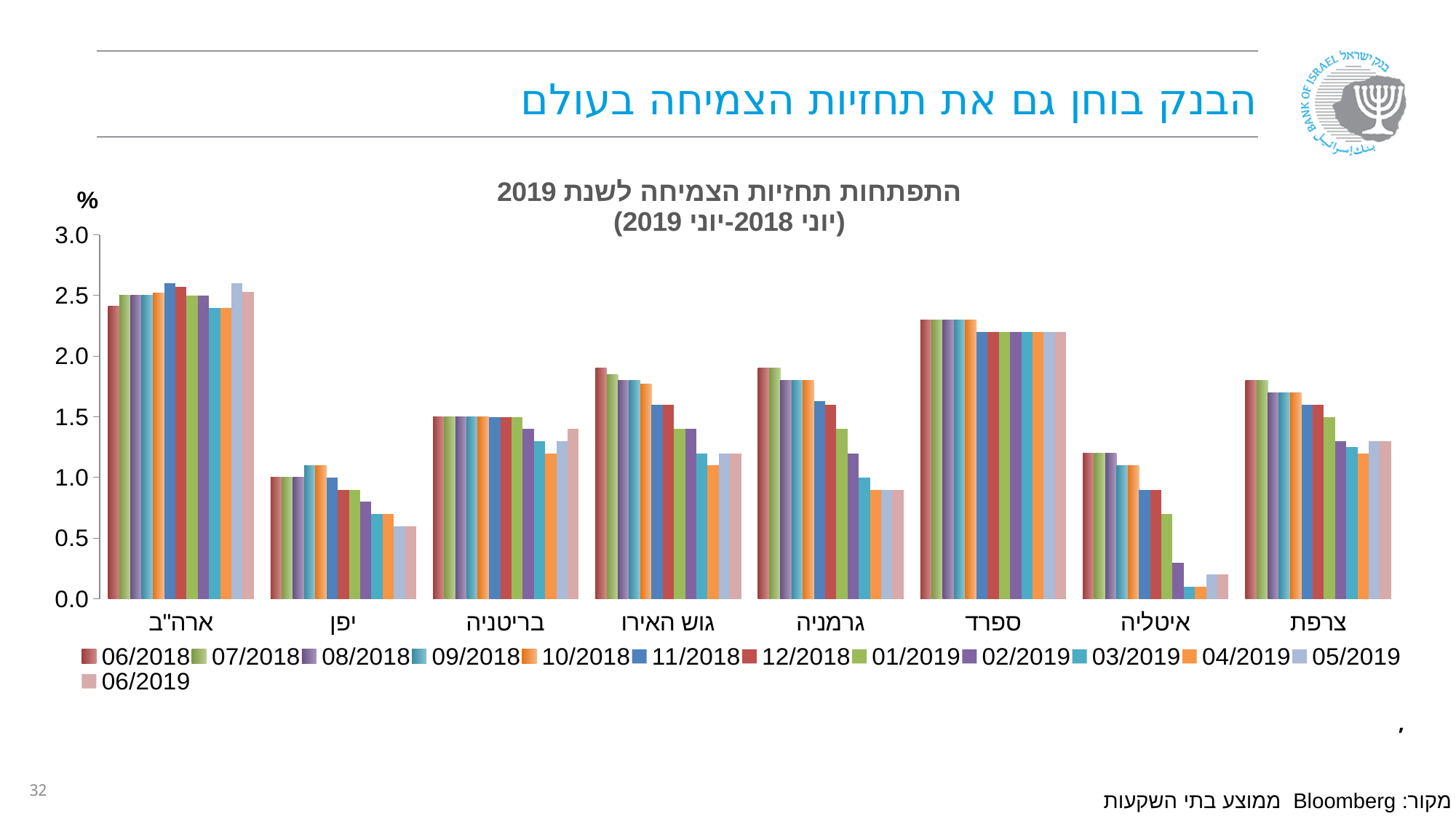
What kind of chart is shown on the slide? bar chart How many series does the legend list? 13 Is the 06/2018 value for ספרד greater or less than 2.0? greater How many countries (categories) are shown on the x axis? 8 Is the 06/2019 value for איטליה greater or less than 0.5? less Which is larger, the 06/2018 value for גרמניה or the 06/2018 value for יפן? גרמניה What is the 06/2018 value for בריטניה? 1.5 Which country has the highest 06/2019 value? ארה"ב Is the 06/2019 value for ארה"ב greater or less than 2.0? greater Which country has the lowest 06/2019 value? איטליה What is the title of the chart? התפתחות תחזיות הצמיחה לשנת 2019 (יוני 2018-יוני 2019) Do the values for איטליה rise or fall from 06/2018 to 06/2019? fall